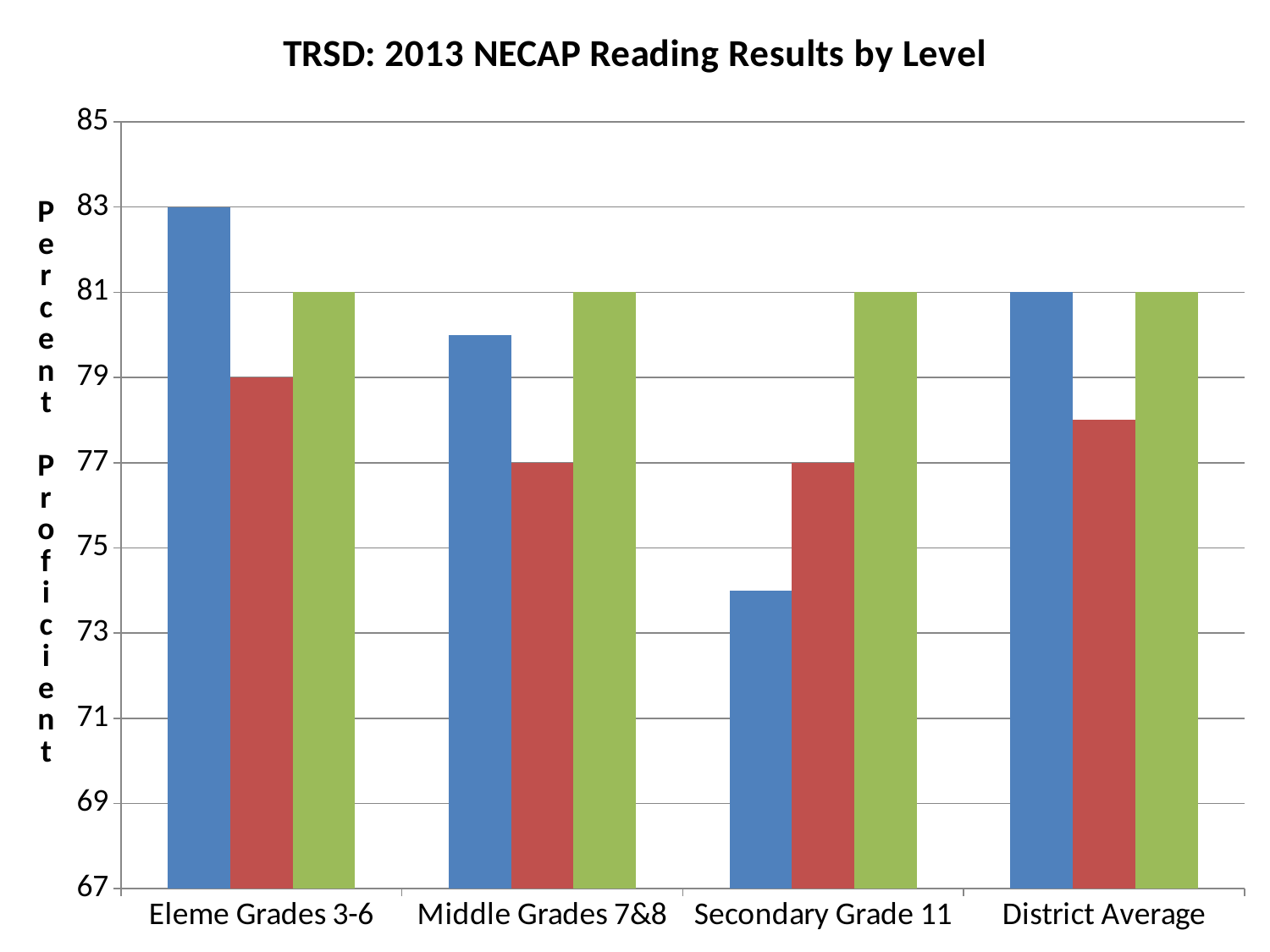
What is the value of the blue bar for Eleme Grades 3-6? 83 Which category has the highest blue bar? Eleme Grades 3-6 What is the title of the chart? TRSD: 2013 NECAP Reading Results by Level What is the difference between the blue bar and the red bar for Eleme Grades 3-6? 4 What is the value of the red bar for Eleme Grades 3-6? 79 What is the value of the green bar for Middle Grades 7&8? 81 Is the value of the blue bar for Secondary Grade 11 greater or less than 75? less Which category has the lowest blue bar? Secondary Grade 11 What is the value of the blue bar for District Average? 81 What is the value of the red bar for Secondary Grade 11? 77 How many categories are shown on the x axis? 4 What kind of chart is shown on the slide? bar chart